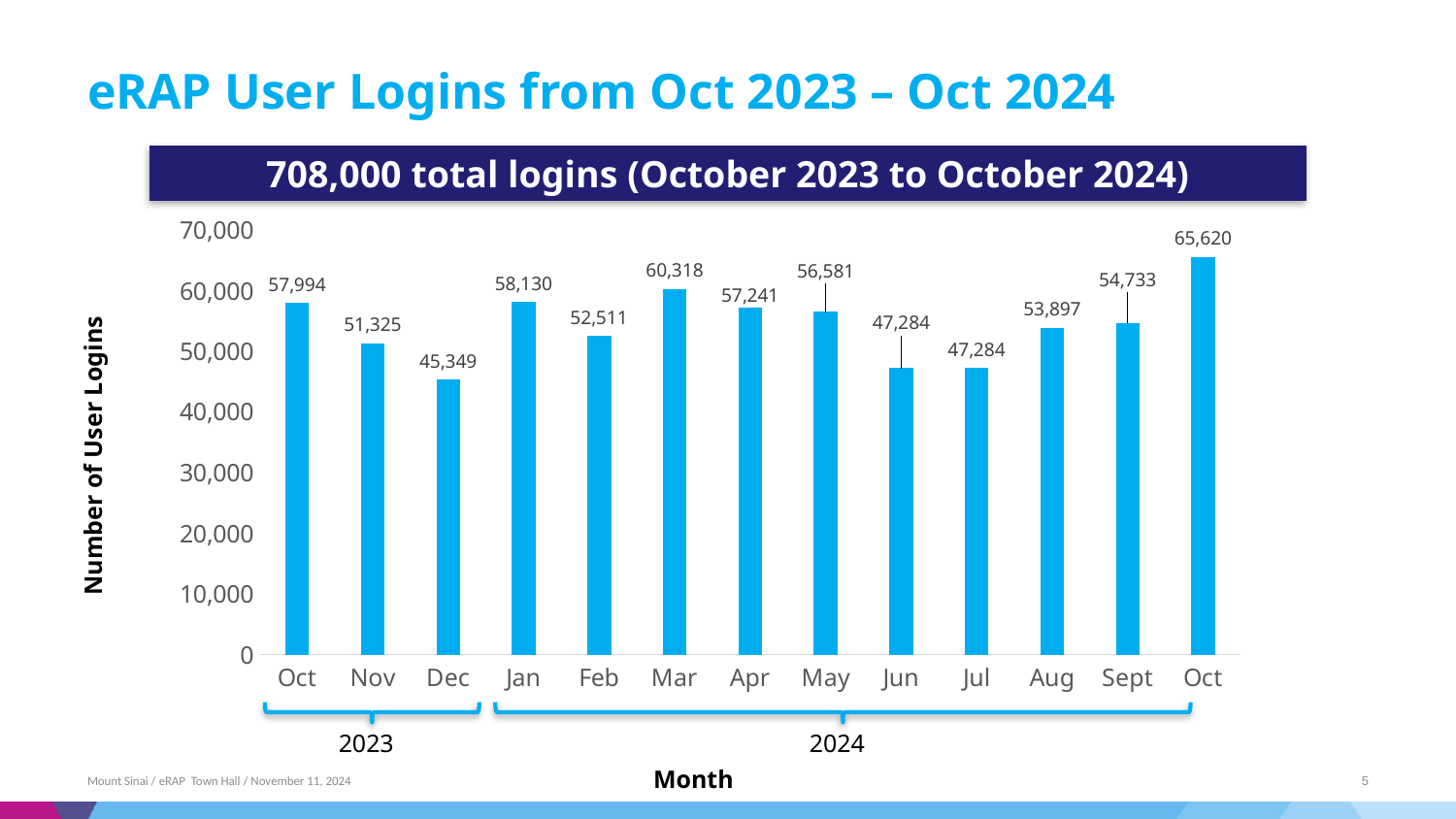
Which month has the highest number of user logins? Oct 2024 What is the number of user logins for Dec 2023? 45,349 Do user logins rise or fall from Oct 2023 to Dec 2023? fall Which month has the lowest number of user logins? Dec 2023 Is the value for Jun 2024 greater or less than 50,000? less How many months are plotted in the chart? 13 What kind of chart is shown on the slide? bar chart What is the number of user logins for Oct 2024? 65,620 What is the difference in user logins between Jan 2024 and Dec 2023? 12,781 What is the difference in user logins between Oct 2024 and Oct 2023? 7,626 Which month has more user logins, Mar 2024 or Apr 2024? Mar 2024 What is the number of user logins for Mar 2024? 60,318